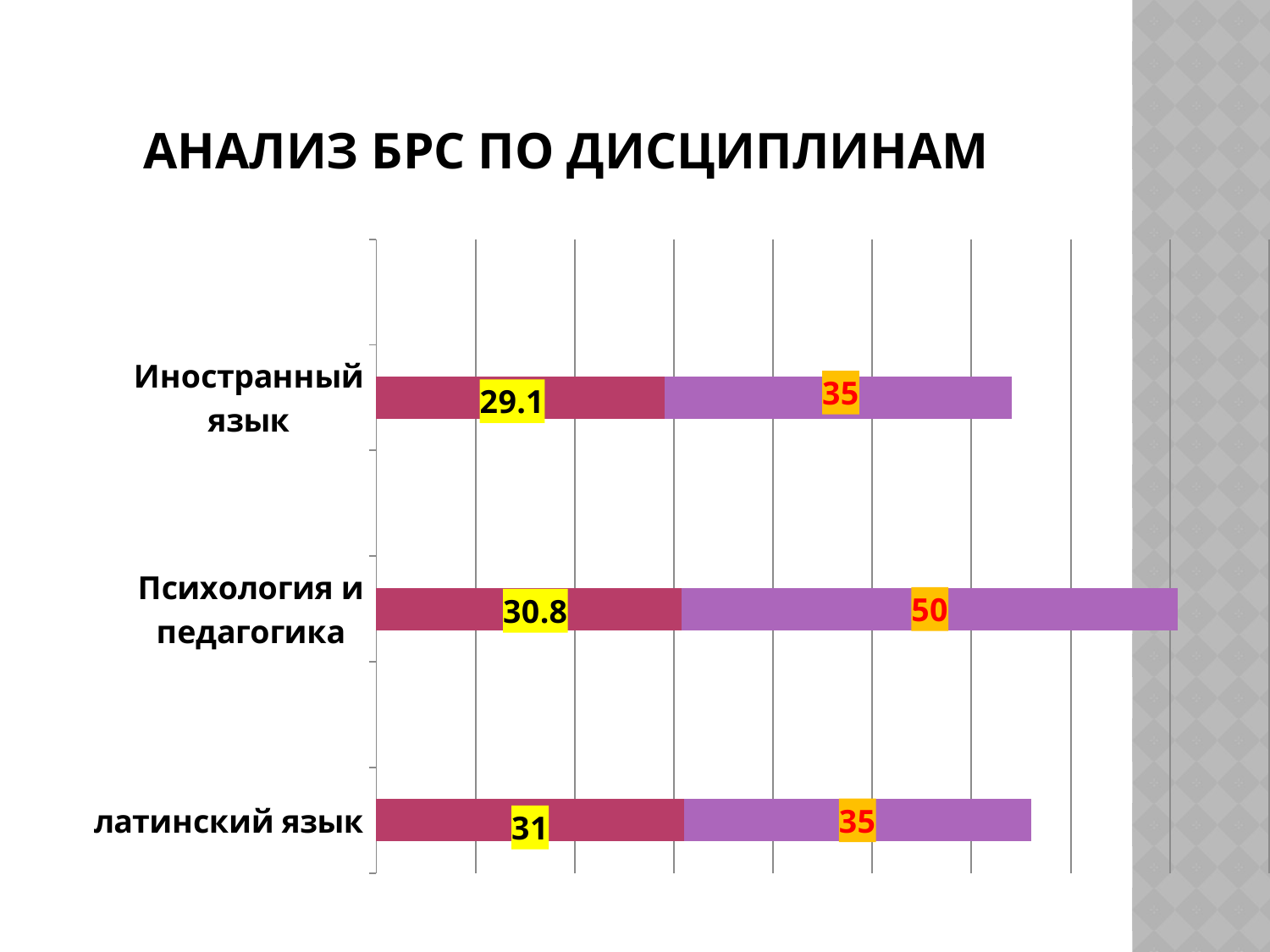
What is the total of the stacked bar for Психология и педагогика? 80.8 What is the value of the red (first) segment for латинский язык? 31 Which discipline has the lowest value in the red (first) segment? Иностранный язык What is the value of the red (first) segment for Иностранный язык? 29.1 What type of chart is shown on the slide? Stacked bar chart What is the title of the chart on the slide? АНАЛИЗ БРС ПО ДИСЦИПЛИНАМ What is the difference between the purple segment values for Психология и педагогика and латинский язык? 15 Which is larger: the red segment for латинский язык or the red segment for Психология и педагогика? латинский язык How many categories (disciplines) are shown in the chart? 3 What is the value of the purple (second) segment for Иностранный язык? 35 Which discipline has the highest value in the purple (second) segment? Психология и педагогика What is the value of the purple (second) segment for Психология и педагогика? 50